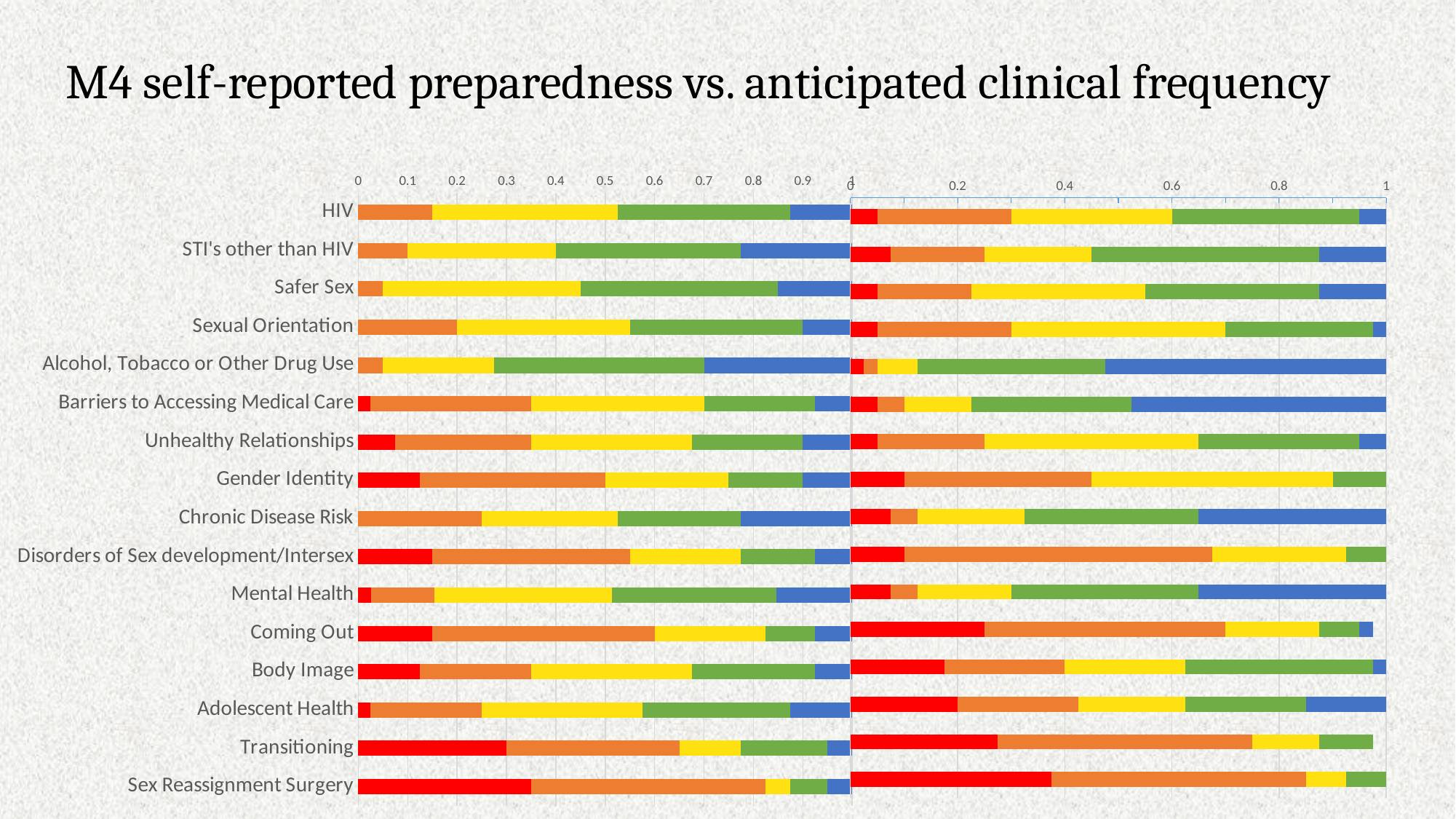
In the right chart, which has the longer red segment: Coming Out or Body Image? Coming Out In the left chart, which category has the longest red segment? Sex Reassignment Surgery In the left chart, which has the longer red segment: Transitioning or Sex Reassignment Surgery? Sex Reassignment Surgery In the right chart, which category has the longest red segment? Sex Reassignment Surgery What is the title of the slide? M4 self-reported preparedness vs. anticipated clinical frequency What kind of chart is shown on the left side of the slide? Stacked bar chart How many categories are listed along the vertical axis of the charts? 16 In the left chart, is the red segment for Gender Identity greater or less than 0.1? greater In the left chart, which category has the longest blue segment? Alcohol, Tobacco or Other Drug Use In the left chart, is the red segment for Sex Reassignment Surgery greater or less than 0.3? greater In the right chart, is the red segment for Sex Reassignment Surgery greater or less than 0.2? greater Which category appears at the top of the charts? HIV